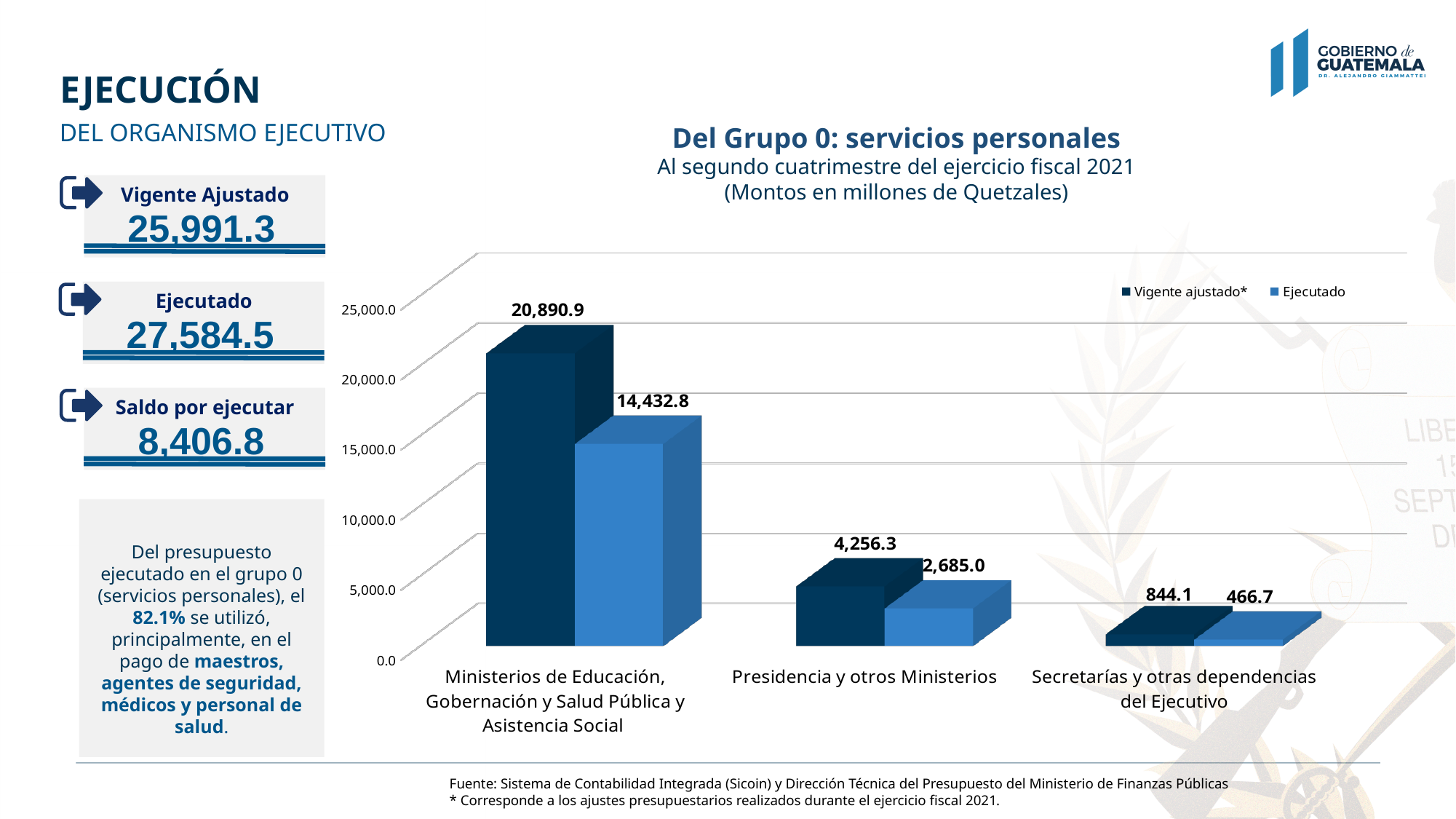
What is the difference between the Vigente ajustado* and Ejecutado values for Secretarías y otras dependencias del Ejecutivo? 377.4 What is the Vigente ajustado* value for Presidencia y otros Ministerios? 4,256.3 How many series does the chart legend list? 2 What kind of chart is shown on the slide? Bar chart How many categories are shown on the x axis of the chart? 3 What is the Vigente ajustado* value for Ministerios de Educación, Gobernación y Salud Pública y Asistencia Social? 20,890.9 What is the difference between the Vigente ajustado* and Ejecutado values for Ministerios de Educación, Gobernación y Salud Pública y Asistencia Social? 6,458.1 What is the Ejecutado value for Presidencia y otros Ministerios? 2,685.0 Which category has the highest Ejecutado value? Ministerios de Educación, Gobernación y Salud Pública y Asistencia Social Which is larger: the Ejecutado value for Presidencia y otros Ministerios or the Vigente ajustado* value for Secretarías y otras dependencias del Ejecutivo? Ejecutado for Presidencia y otros Ministerios What is the Ejecutado value for Secretarías y otras dependencias del Ejecutivo? 466.7 Which category has the lowest Vigente ajustado* value? Secretarías y otras dependencias del Ejecutivo